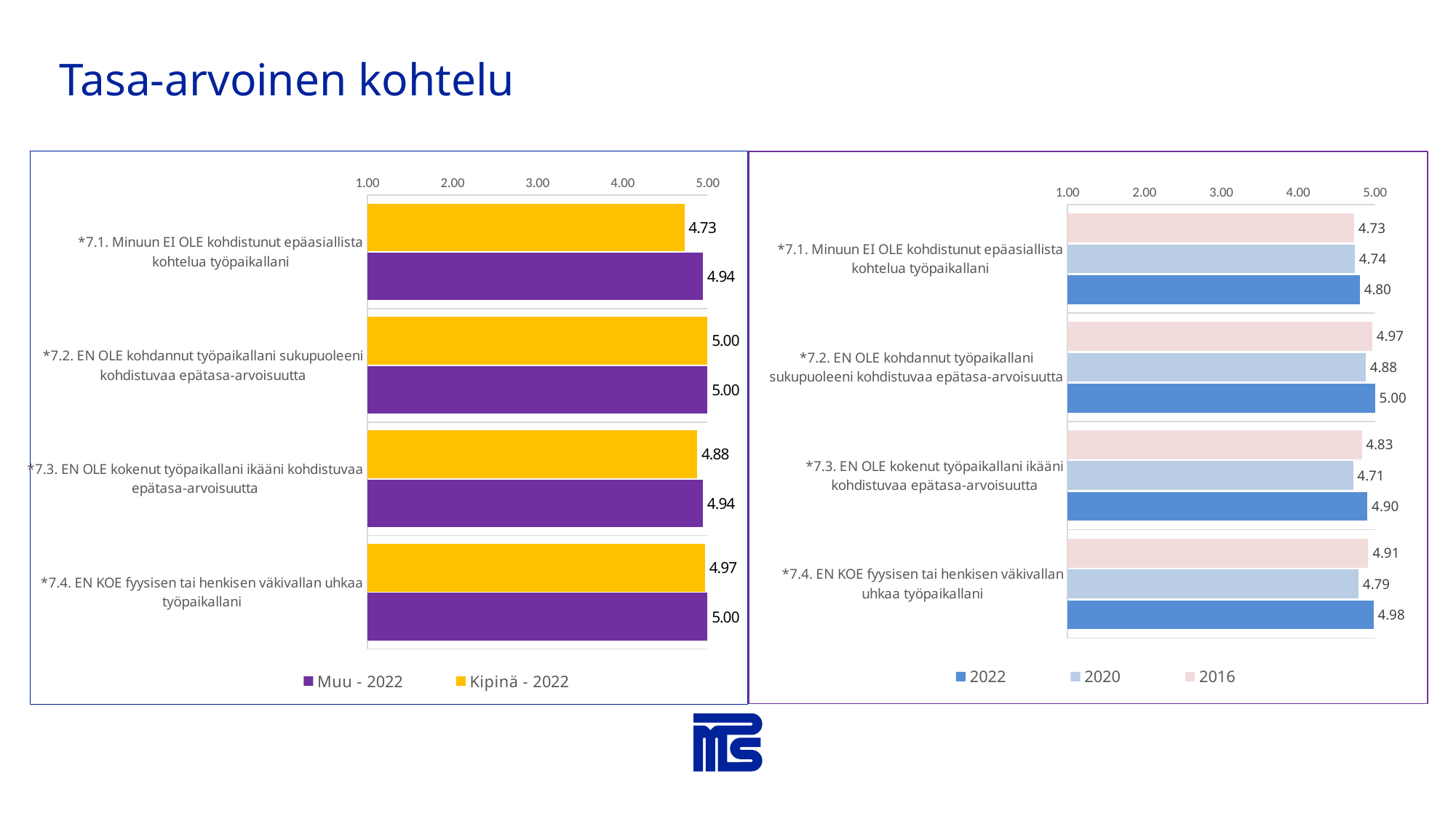
In the right chart, is the 2022 value for *7.4. EN KOE fyysisen tai henkisen väkivallan uhkaa työpaikallani larger or smaller than the 2020 value? Larger What kind of chart is the chart on the right? Bar chart In the right chart, how many categories are shown? 4 In the left chart, how many series does the legend list? 2 In the left chart, what is the Kipinä - 2022 value for *7.1. Minuun EI OLE kohdistunut epäasiallista kohtelua työpaikallani? 4.73 In the left chart, what is the difference between the Muu - 2022 and Kipinä - 2022 values for *7.1. Minuun EI OLE kohdistunut epäasiallista kohtelua työpaikallani? 0.21 In the right chart, which year has the highest value for *7.4. EN KOE fyysisen tai henkisen väkivallan uhkaa työpaikallani? 2022 In the right chart, what is the 2016 value for *7.2. EN OLE kohdannut työpaikallani sukupuoleeni kohdistuvaa epätasa-arvoisuutta? 4.97 In the left chart, which category has the lowest Kipinä - 2022 value? *7.1. Minuun EI OLE kohdistunut epäasiallista kohtelua työpaikallani In the right chart, what is the difference between the 2022 and 2020 values for *7.4. EN KOE fyysisen tai henkisen väkivallan uhkaa työpaikallani? 0.19 In the right chart, what is the 2020 value for *7.3. EN OLE kokenut työpaikallani ikääni kohdistuvaa epätasa-arvoisuutta? 4.71 In the left chart, what is the Muu - 2022 value for *7.3. EN OLE kokenut työpaikallani ikääni kohdistuvaa epätasa-arvoisuutta? 4.94